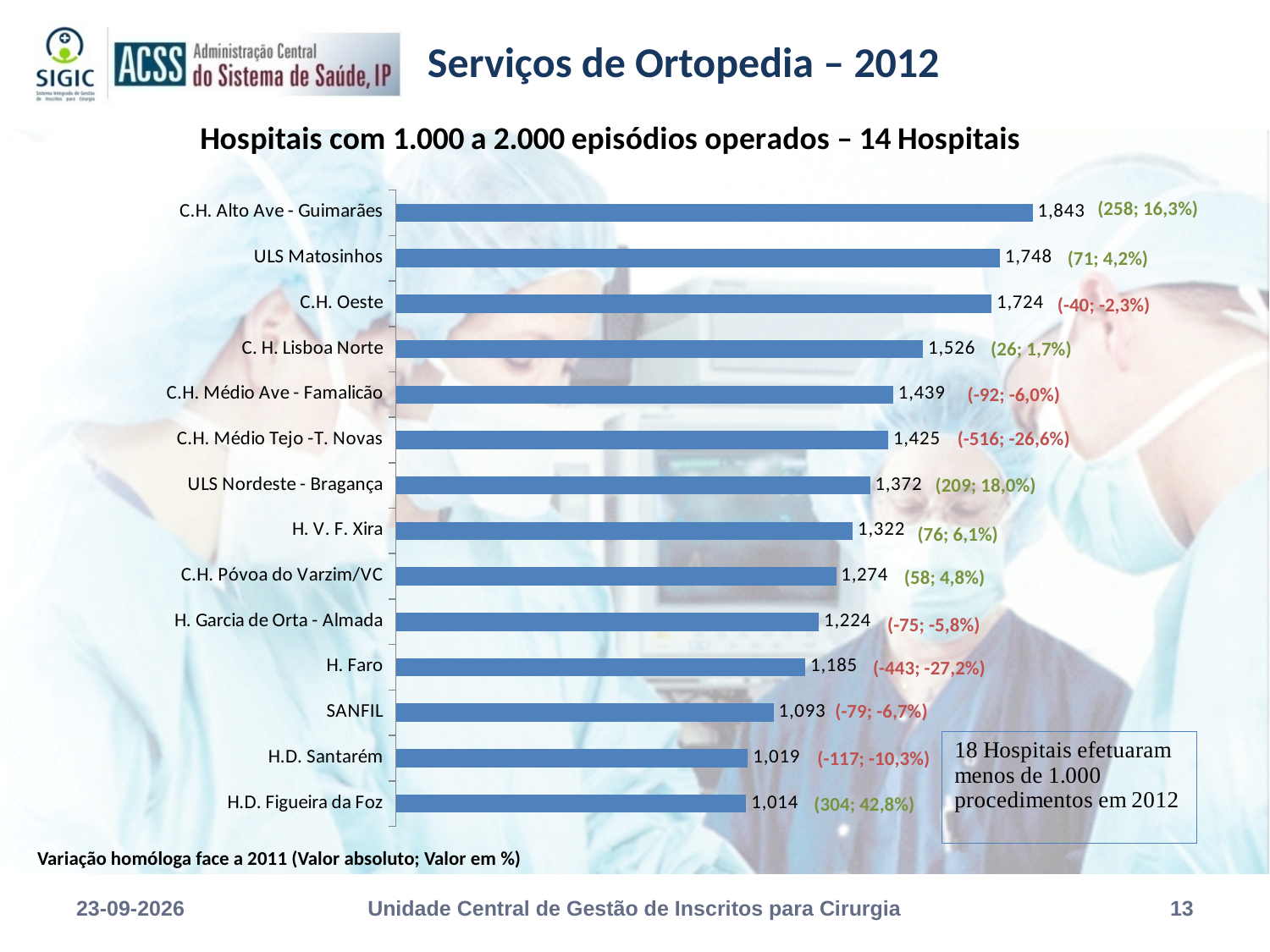
What is the title of the chart? Hospitais com 1.000 a 2.000 episódios operados – 14 Hospitais What is the value for C.H. Alto Ave - Guimarães? 1,843 What is the value for H. Faro? 1,185 What is the difference between the values for ULS Matosinhos and C.H. Oeste? 24 What is the variation shown in parentheses next to the bar for H.D. Figueira da Foz? (304; 42,8%) What kind of chart is shown on the slide? Bar chart What is the difference between the values for C.H. Alto Ave - Guimarães and H.D. Figueira da Foz? 829 Which hospital has the highest value? C.H. Alto Ave - Guimarães Which hospital has the lowest value? H.D. Figueira da Foz What is the value for ULS Nordeste - Bragança? 1,372 How many hospitals are shown in the chart? 14 Which is larger, the value for C. H. Lisboa Norte or the value for H. V. F. Xira? C. H. Lisboa Norte